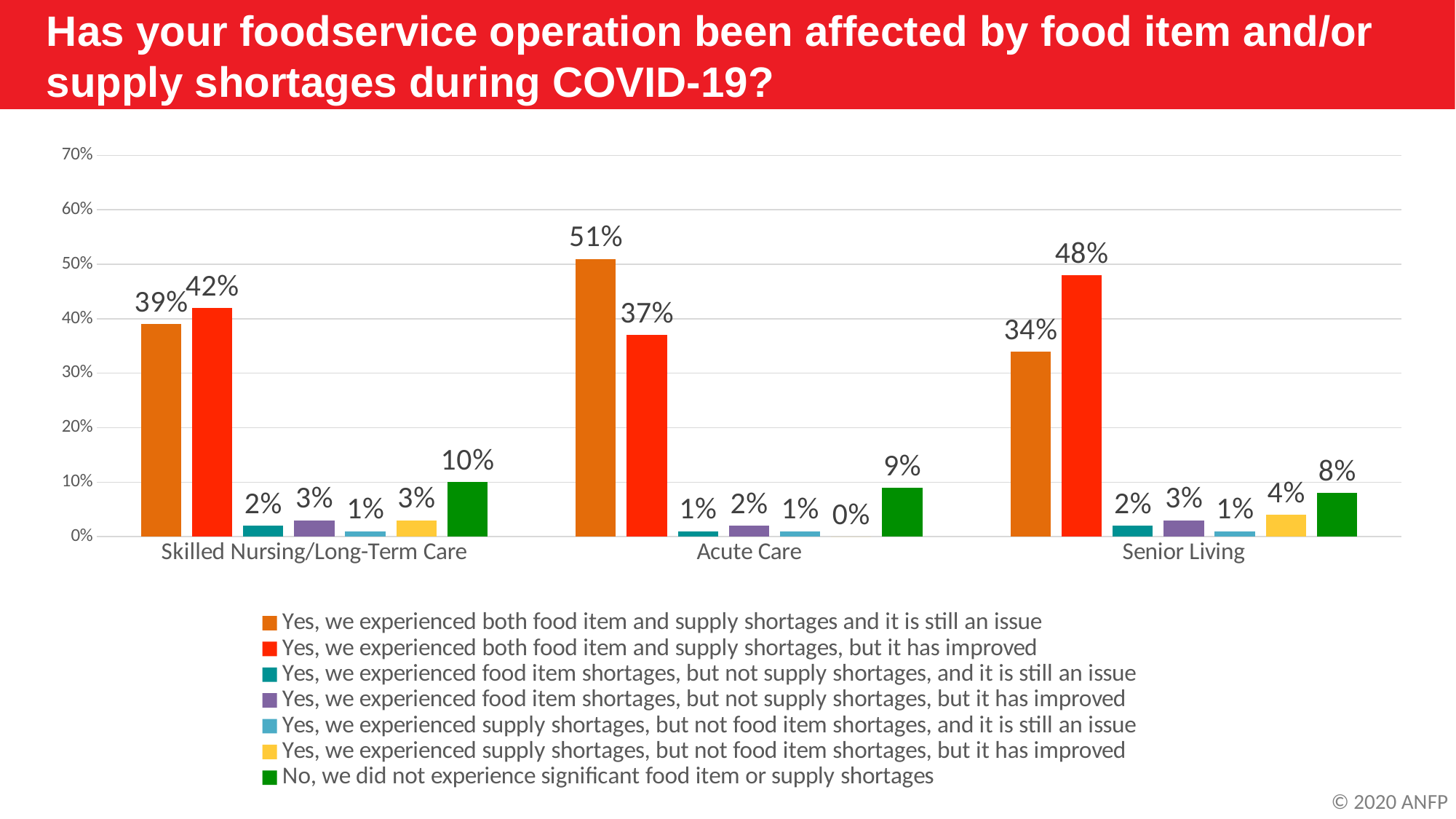
What is the value for 'Yes, we experienced supply shortages, but not food item shortages, but it has improved' for Acute Care? 0% Which category has the lowest value for 'No, we did not experience significant food item or supply shortages'? Senior Living How many categories are shown on the x axis? 3 What kind of chart is shown on the slide? Bar chart What percentage of Senior Living respondents said they experienced supply shortages, but not food item shortages, but it has improved? 4% What percentage of Skilled Nursing/Long-Term Care respondents said they did not experience significant food item or supply shortages? 10% For Acute Care, which is larger: 'both shortages and it is still an issue' or 'both shortages, but it has improved'? Both shortages and it is still an issue Which category has the highest value for 'Yes, we experienced both food item and supply shortages and it is still an issue'? Acute Care How many series does the legend list? 7 What is the difference between the 'both shortages, but it has improved' value and the 'both shortages and it is still an issue' value for Senior Living? 14% What percentage of Senior Living respondents said they experienced both food item and supply shortages, but it has improved? 48% What percentage of Acute Care respondents said they experienced both food item and supply shortages and it is still an issue? 51%